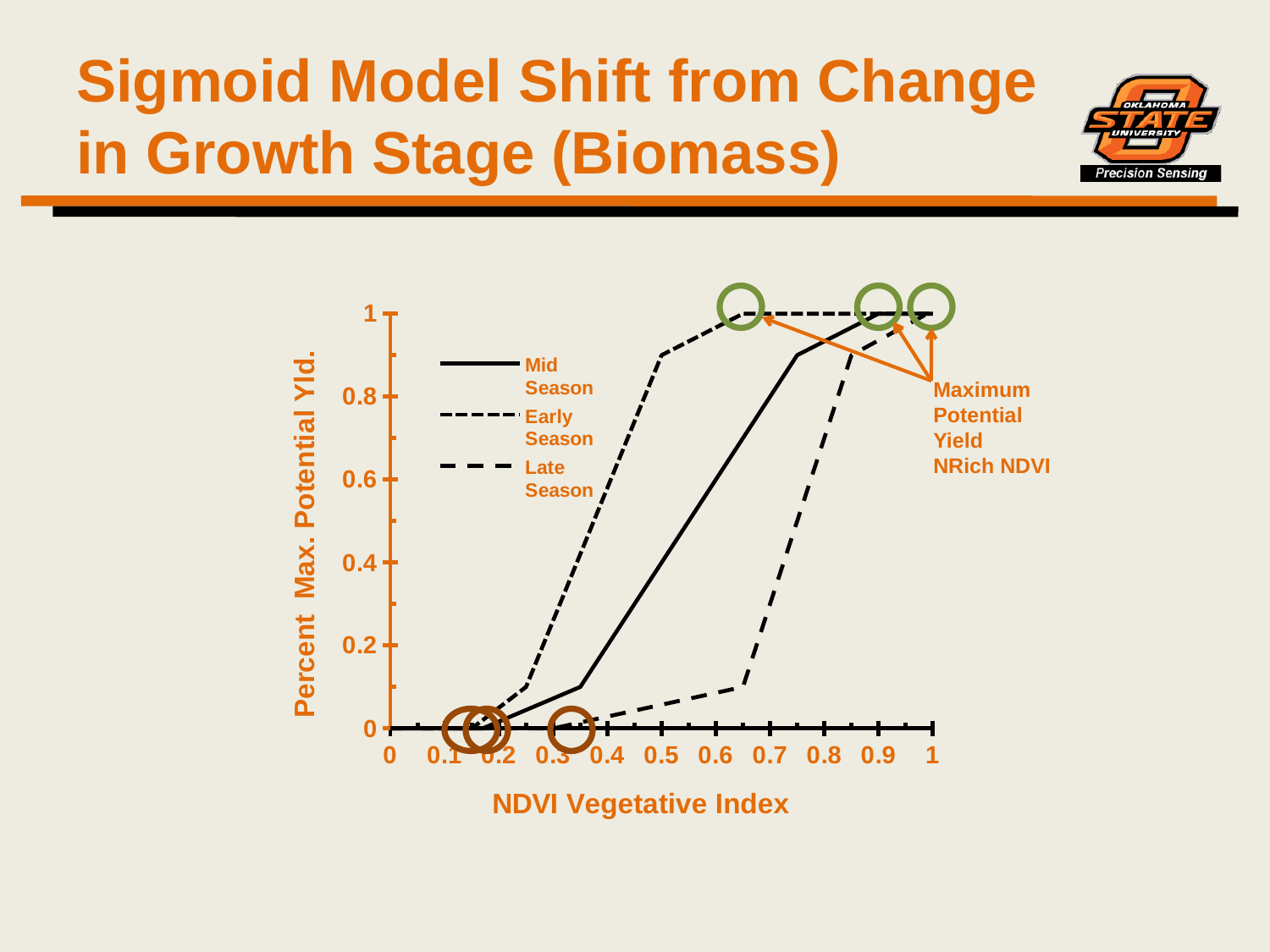
Is the value for Mid Season at an NDVI of 0.8 greater or less than 0.8? greater At an NDVI of 0.5, which series has the larger value, Early Season or Mid Season? Early Season Which series has the lowest value at an NDVI of 0.6? Late Season Is the value for Early Season at an NDVI of 0.5 greater or less than 0.8? greater What is the title of the y axis? Percent Max. Potential Yld. Which series reaches a value of 1 at the lowest NDVI? Early Season How many series does the legend list? 3 What is the title of the x axis? NDVI Vegetative Index Do the values of the Mid Season series rise or fall as NDVI increases? rise What kind of chart is shown on the slide? line chart Is the value for Late Season at an NDVI of 0.6 greater or less than 0.2? less At an NDVI of 0.7, which series has the larger value, Mid Season or Late Season? Mid Season